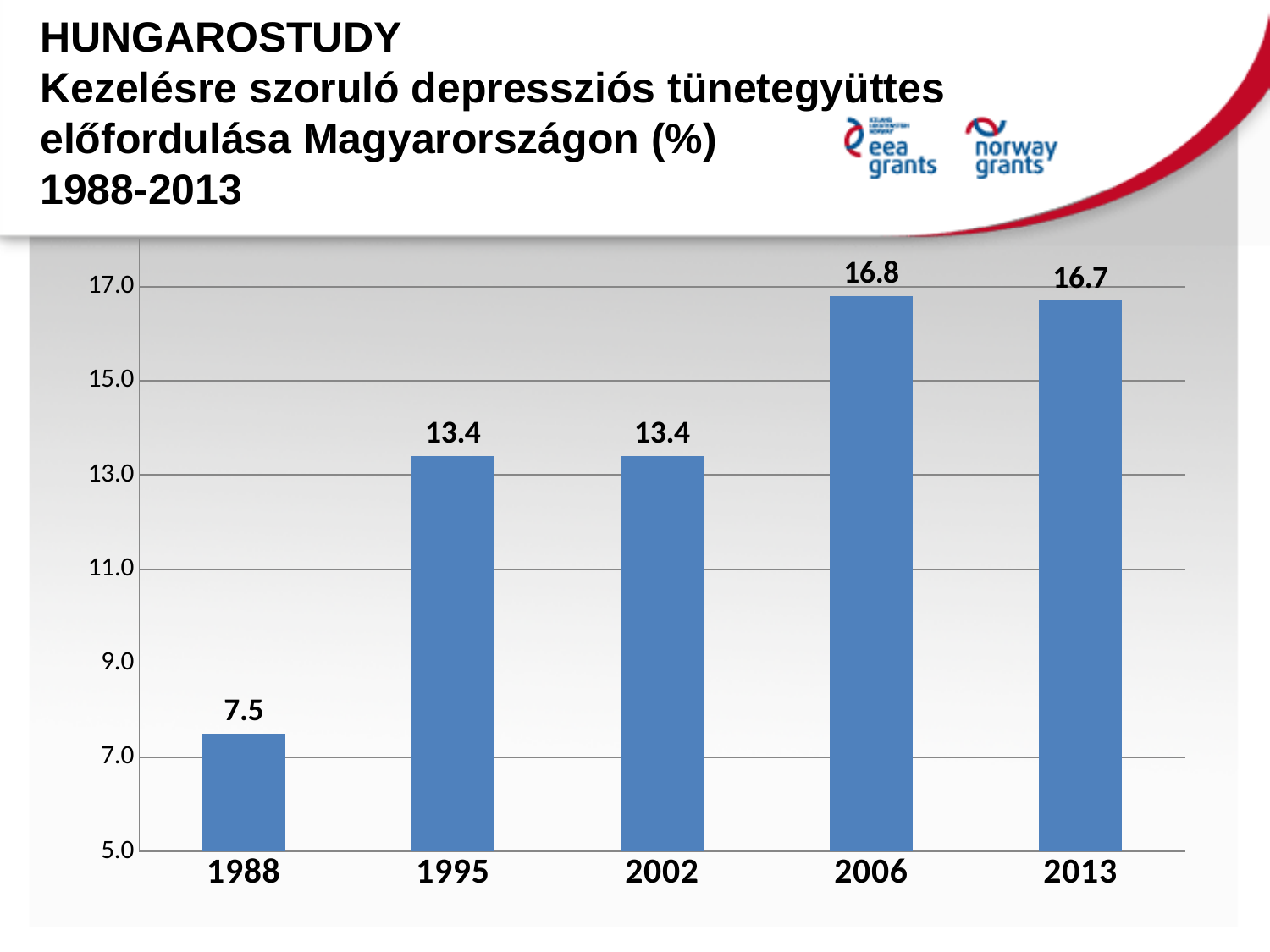
How many years are shown on the x axis? 5 Which year has the lowest value? 1988 Which is larger, the value for 2002 or the value for 2013? 2013 Which year has the highest value? 2006 What is the value for 2006? 16.8 What is the value for 2013? 16.7 What is the difference between the values for 1995 and 1988? 5.9 What is the difference between the values for 2006 and 1988? 9.3 Is the value for 1988 greater or less than 9.0? less What kind of chart is shown on the slide? bar chart What is the value for 1995? 13.4 What is the value for 1988? 7.5